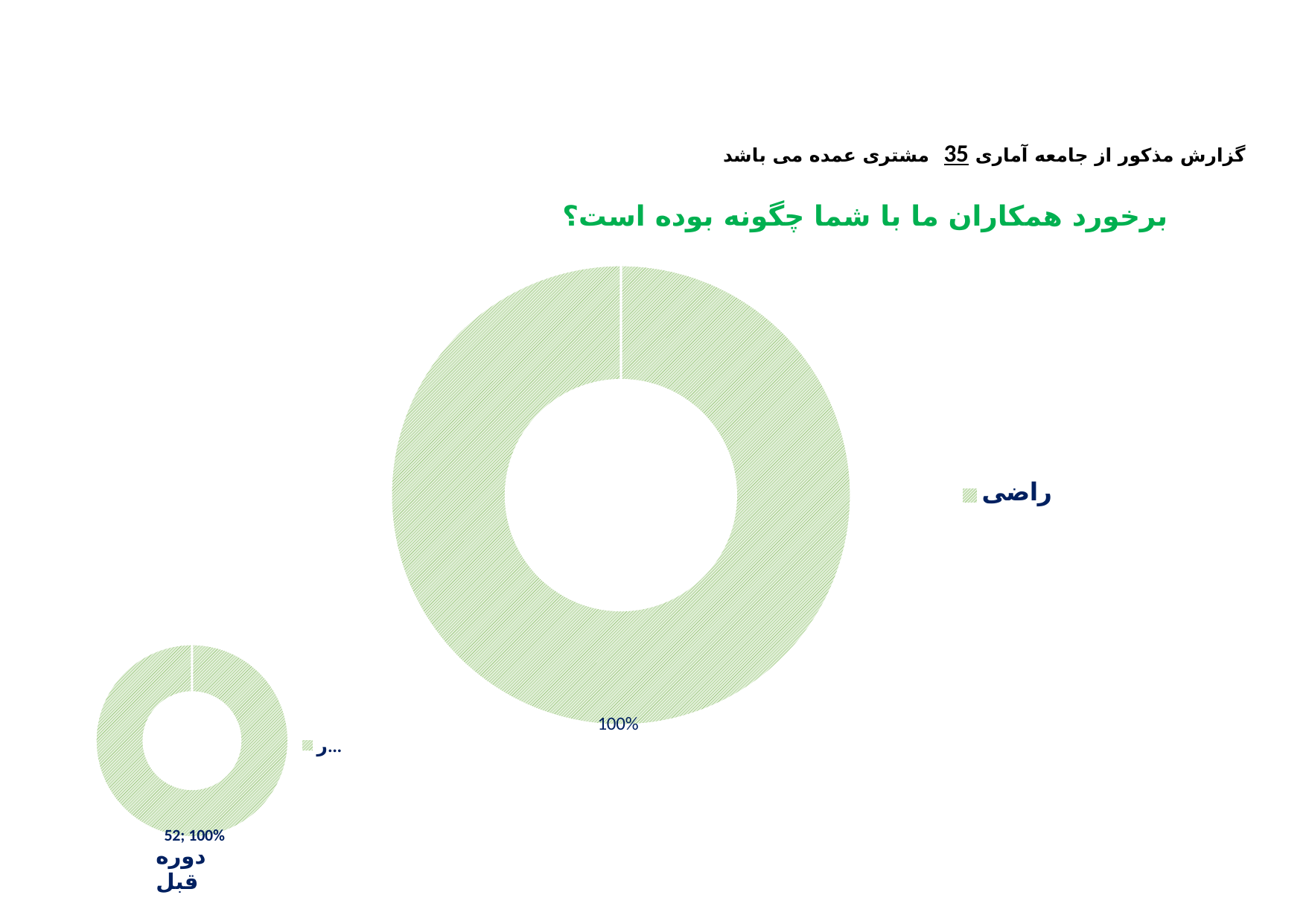
How many slices does the large chart titled "برخورد همکاران ما با شما چگونه بوده است؟" have? 1 What kind of chart is the large chart titled "برخورد همکاران ما با شما چگونه بوده است؟"? Doughnut (pie) chart In the small chart at the bottom left labelled "دوره قبل", what percentage share is printed on the data label? 100% How many slices does the small chart at the bottom left labelled "دوره قبل" have? 1 How many entries does the legend of the large chart titled "برخورد همکاران ما با شما چگونه بوده است؟" list? 1 In the small chart at the bottom left labelled "دوره قبل", what value is printed on the data label? 52 What kind of chart is the small chart at the bottom left labelled "دوره قبل"? Doughnut (pie) chart In the large chart titled "برخورد همکاران ما با شما چگونه بوده است؟", what share does the "راضی" slice have? 100% In the small chart at the bottom left labelled "دوره قبل", is the printed value greater or less than 50? greater What is the legend entry of the large chart titled "برخورد همکاران ما با شما چگونه بوده است؟"? راضی What is the title of the large chart on the slide? برخورد همکاران ما با شما چگونه بوده است؟